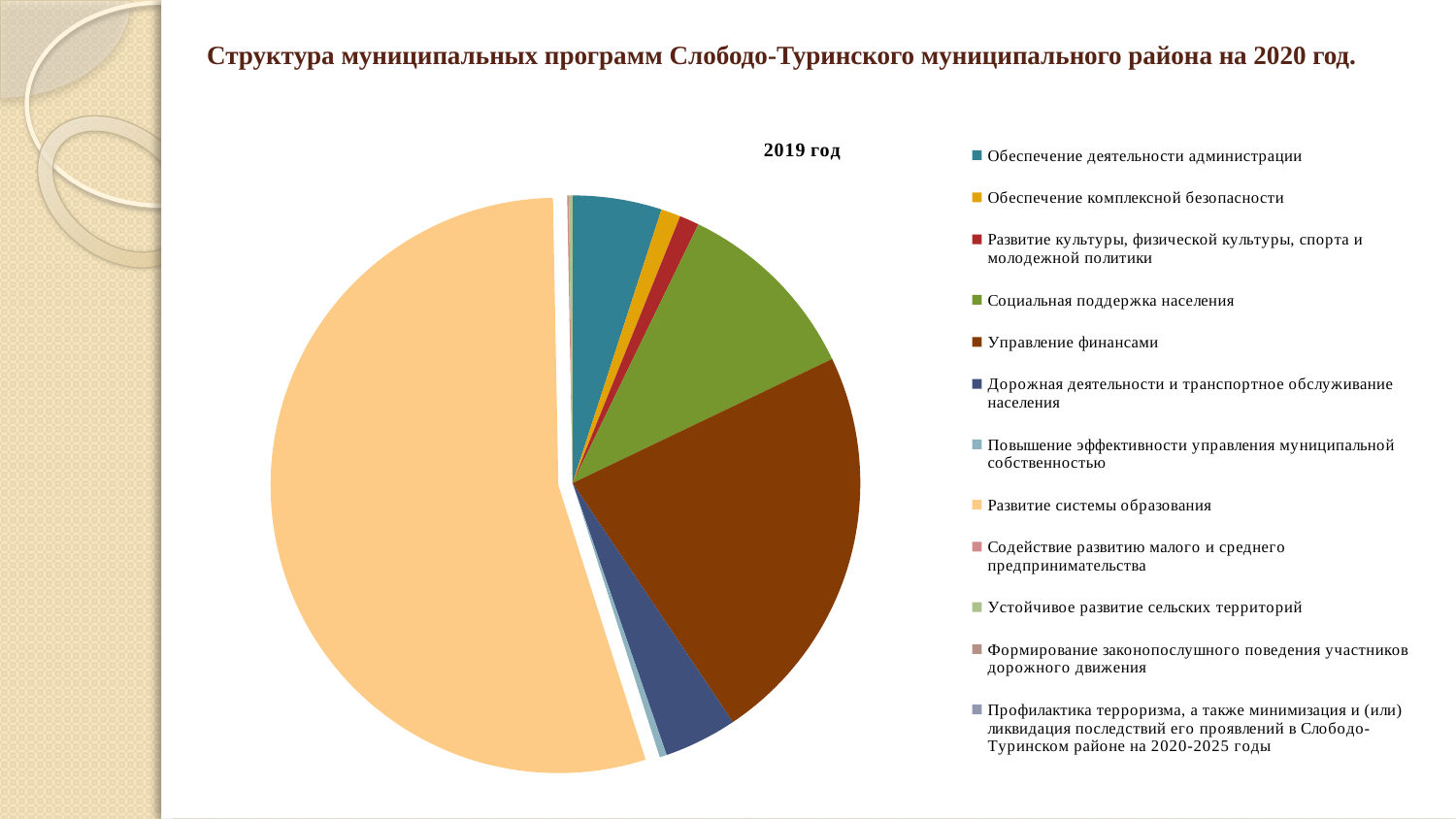
Which category has the largest slice of the pie chart? Развитие системы образования Which slice is larger: Управление финансами or Дорожная деятельности и транспортное обслуживание населения? Управление финансами Which slice is larger: Управление финансами or Социальная поддержка населения? Управление финансами How many categories does the legend of the pie chart list? 12 Which category is the second-largest slice of the pie chart? Управление финансами Which slice is larger: Обеспечение деятельности администрации or Обеспечение комплексной безопасности? Обеспечение деятельности администрации What is the title shown above the pie chart? 2019 год What colour is the slice for Развитие системы образования? light orange (peach) What kind of chart is shown on the slide? pie chart